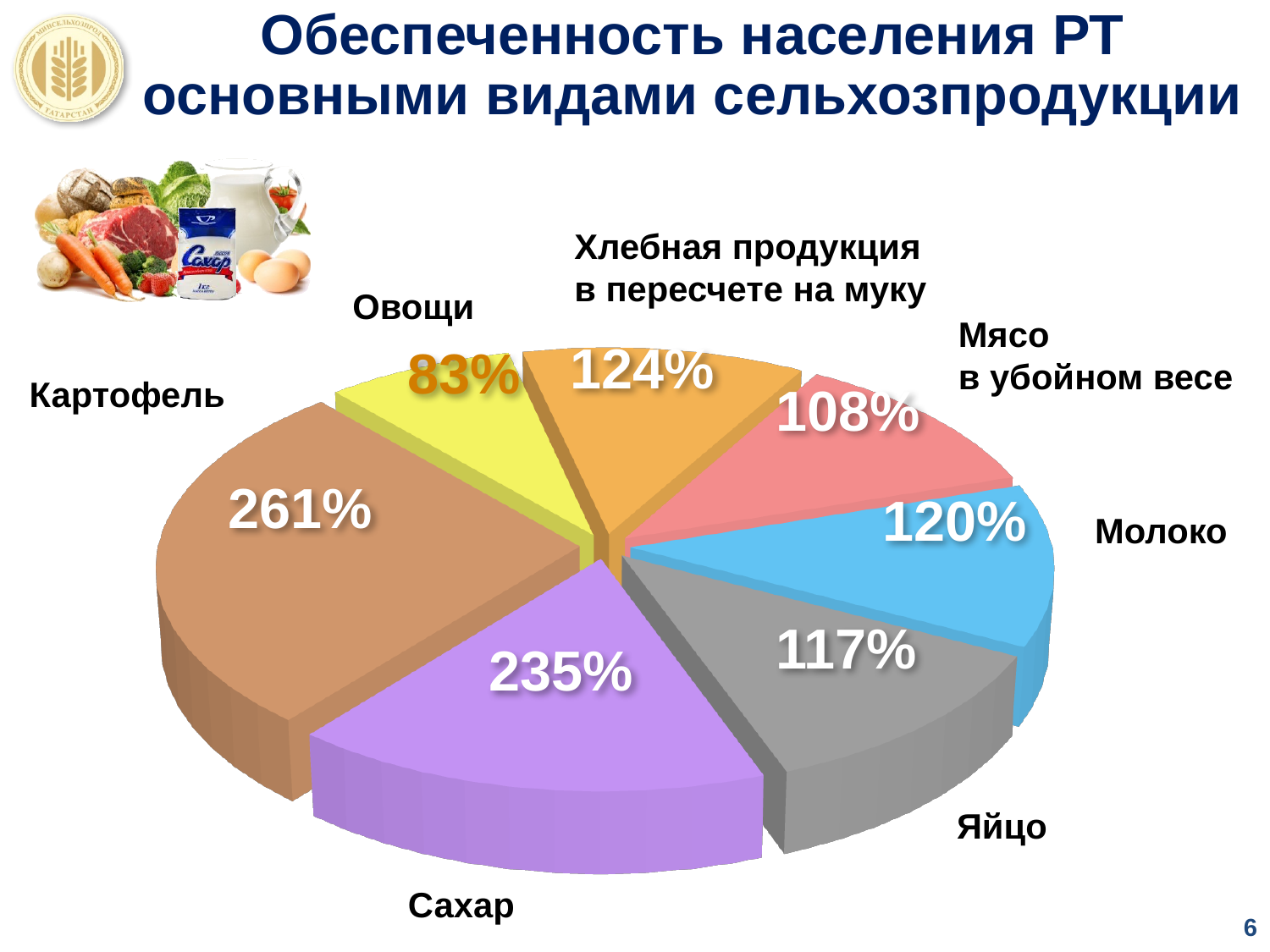
What kind of chart is shown on the slide? Pie chart Which is larger, the value for Молоко or the value for Яйцо? Молоко What value is shown for Молоко? 120% What value is shown for Сахар? 235% How many categories does the pie chart have? 7 What value is shown for Мясо в убойном весе? 108% What is the difference between the values for Картофель and Сахар? 26% Which category has the lowest value? Овощи Which category has the highest value? Картофель What value is shown for Овощи? 83% What is the difference between the values for Хлебная продукция в пересчете на муку and Яйцо? 7% What value is shown for Картофель? 261%